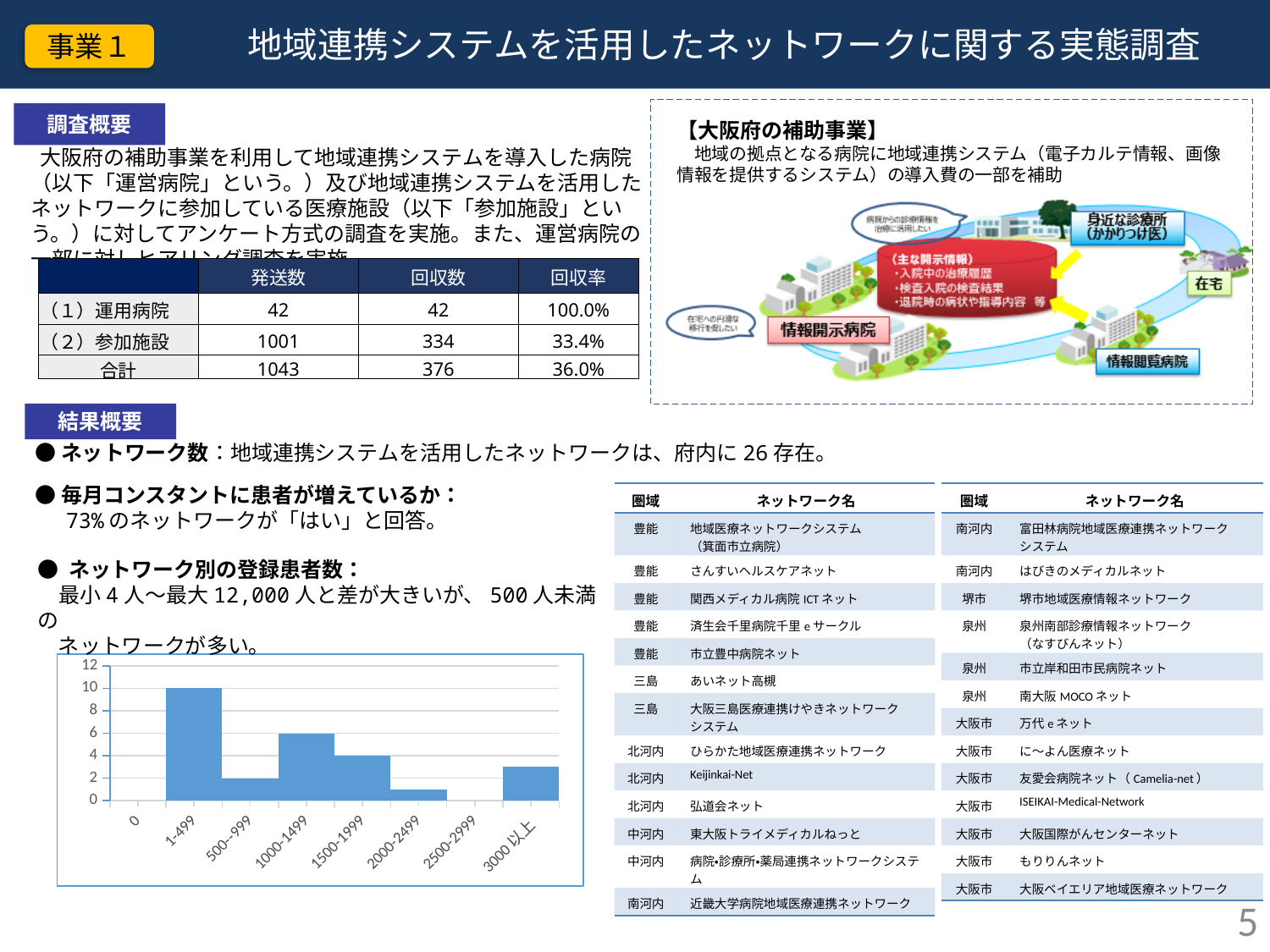
Which is larger in the bar chart, the value for 1-499 or the value for 1000-1499? 1-499 What is the value for the 500-999 category in the bar chart? 2 What is the value for the 1-499 category in the bar chart? 10 What is the value for the 2500-2999 category in the bar chart? 0 What is the value for the 1500-1999 category in the bar chart? 4 Is the value for 3000以上 greater or less than 2? greater How many categories are shown on the x axis of the bar chart? 8 Which category has the highest bar in the chart? 1-499 Is the value for 2000-2499 greater or less than 2? less What is the difference between the values for 1-499 and 1000-1499 in the bar chart? 4 What is the value for the 1000-1499 category in the bar chart? 6 What type of chart is shown at the bottom left of the slide? bar chart